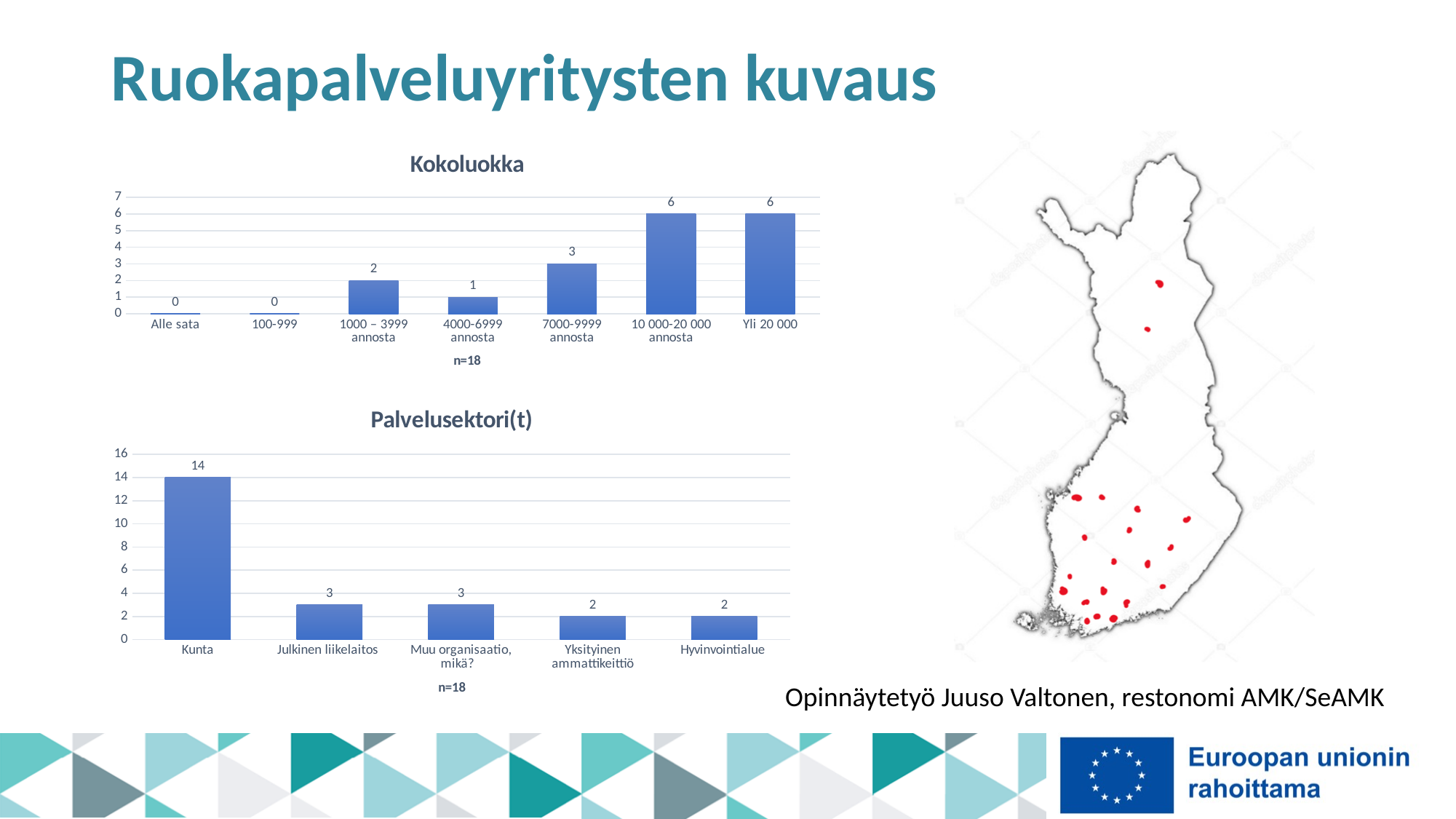
In the Kokoluokka chart, what is the difference between the values for Yli 20 000 and 1000 – 3999 annosta? 4 In the Kokoluokka chart, how many categories are shown on the x axis? 7 In the Palvelusektori(t) chart, what is the value for Kunta? 14 What type of chart is the Palvelusektori(t) chart? Bar chart In the Kokoluokka chart, what is the value for 7000-9999 annosta? 3 In the Kokoluokka chart, which is larger, the value for 7000-9999 annosta or the value for 4000-6999 annosta? 7000-9999 annosta In the Palvelusektori(t) chart, how many categories are shown on the x axis? 5 In the Palvelusektori(t) chart, what is the value for Hyvinvointialue? 2 In the Palvelusektori(t) chart, what is the difference between the values for Kunta and Julkinen liikelaitos? 11 In the Kokoluokka chart, what is the value for 10 000-20 000 annosta? 6 In the Kokoluokka chart, what is the value for 4000-6999 annosta? 1 In the Palvelusektori(t) chart, which category has the highest value? Kunta